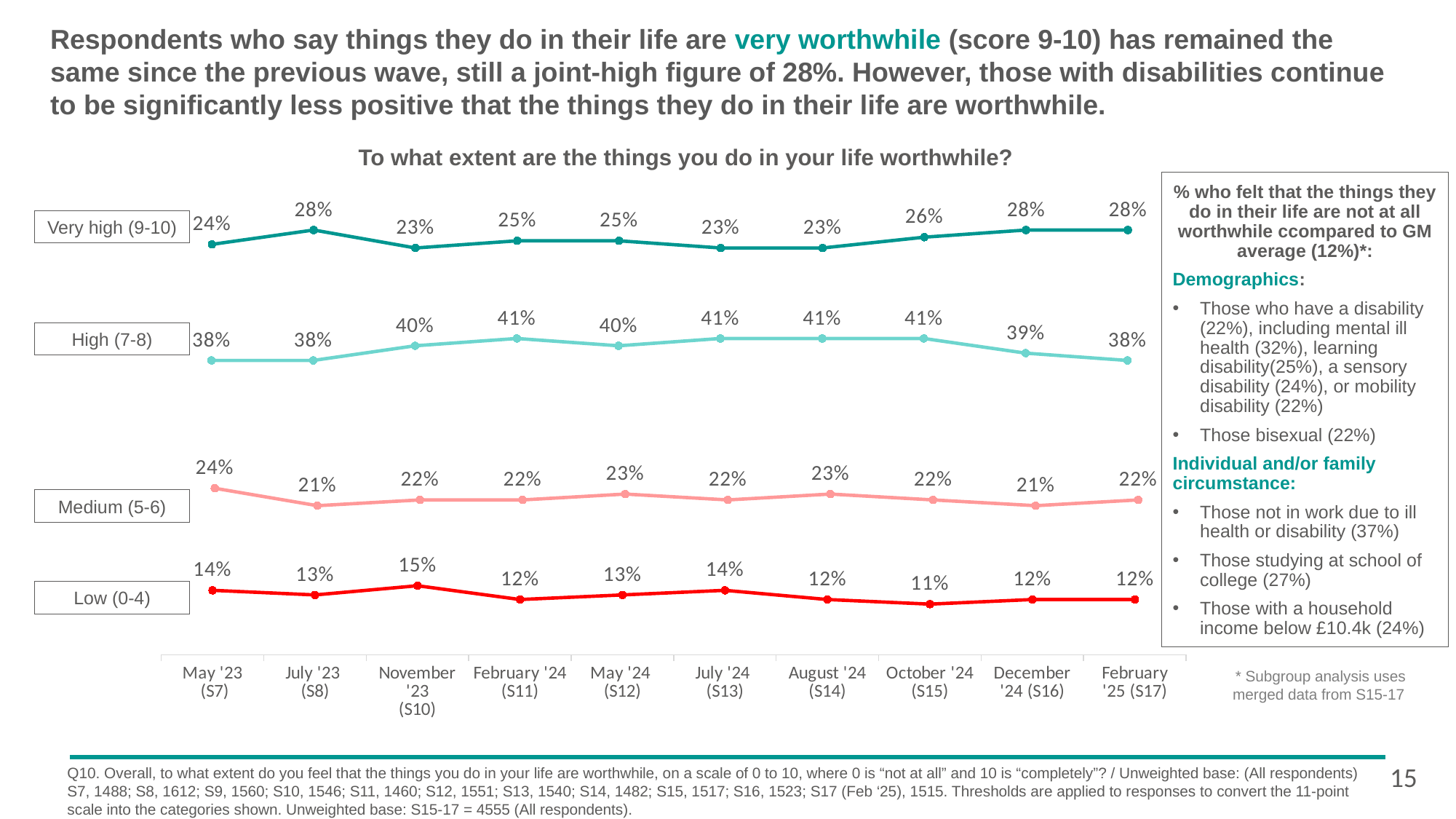
How many series are plotted on the chart? 4 What is the value for High (7-8) in February '24 (S11)? 41% What is the value for Low (0-4) in November '23 (S10)? 15% In which wave is the Low (0-4) series at its lowest value? October '24 (S15) In which wave is the Low (0-4) series at its highest value? November '23 (S10) How many survey waves are shown on the x axis? 10 What is the difference between the High (7-8) and Very high (9-10) values in February '25 (S17)? 10 percentage points Which is larger in May '23 (S7): the Very high (9-10) value or the Medium (5-6) value? They are equal (24%) What is the title of the chart? To what extent are the things you do in your life worthwhile? What type of chart is shown on the slide? Line chart What is the value for Very high (9-10) in February '25 (S17)? 28% What is the value for Medium (5-6) in May '23 (S7)? 24%